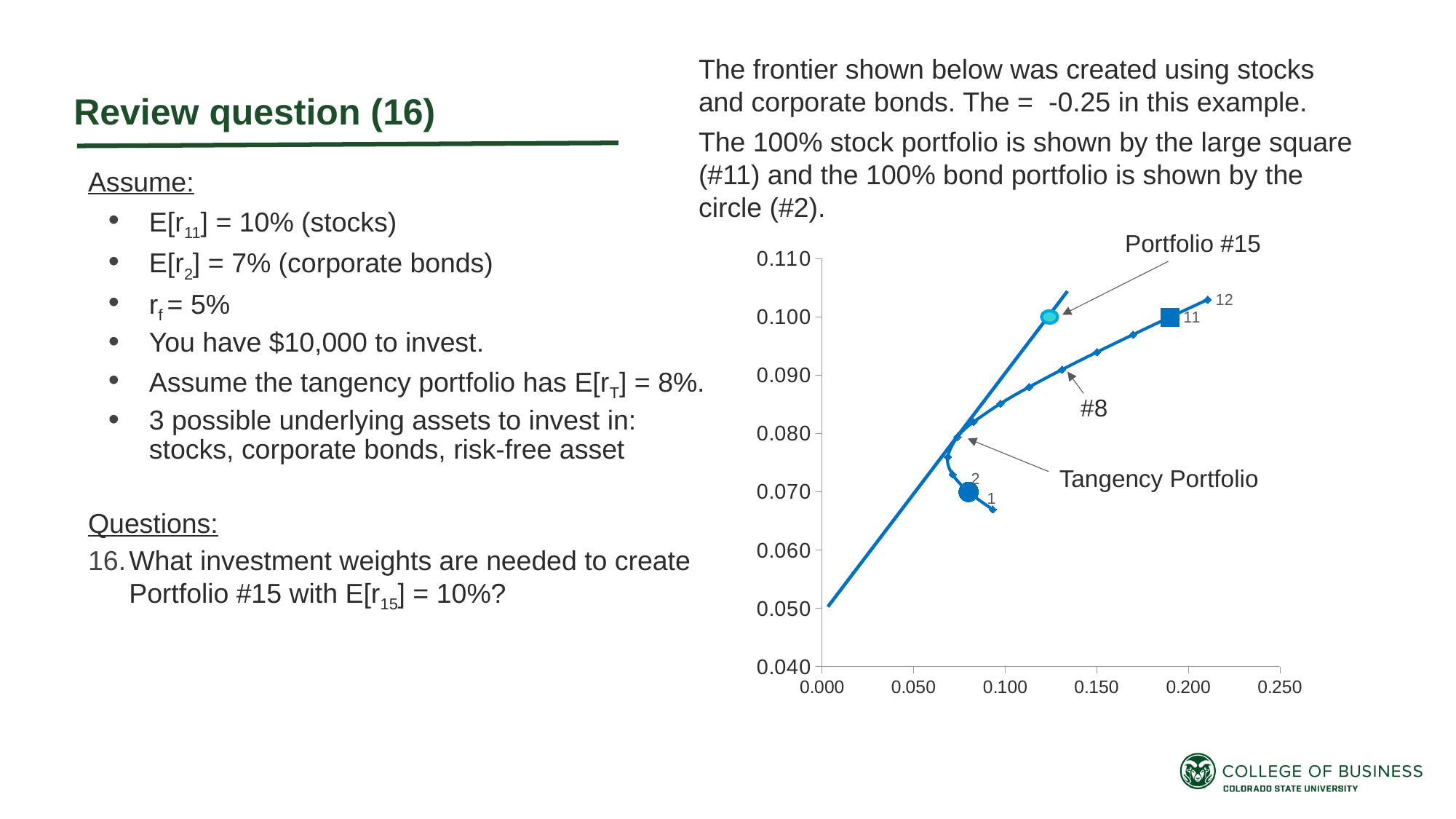
What is the expected return (y-axis value) of Portfolio #15 on the chart? 0.100 Is the expected return of point #1 greater or less than 0.070? less Is the x-axis value (standard deviation) of point #11 greater or less than 0.150? greater What is the expected return (y-axis value) of the 100% bond portfolio, point #2, on the chart? 0.070 What is the highest value shown on the y-axis of the chart? 0.110 Which has the higher expected return, point #11 or point #12? point #12 What kind of chart is shown on the slide? scatter chart Which has the higher expected return, point #1 or point #2? point #2 Is the expected return of point #12 greater or less than 0.100? greater At what y-axis value does the straight line (capital allocation line) start on the vertical axis? 0.050 What is the expected return (y-axis value) of the 100% stock portfolio, point #11, on the chart? 0.100